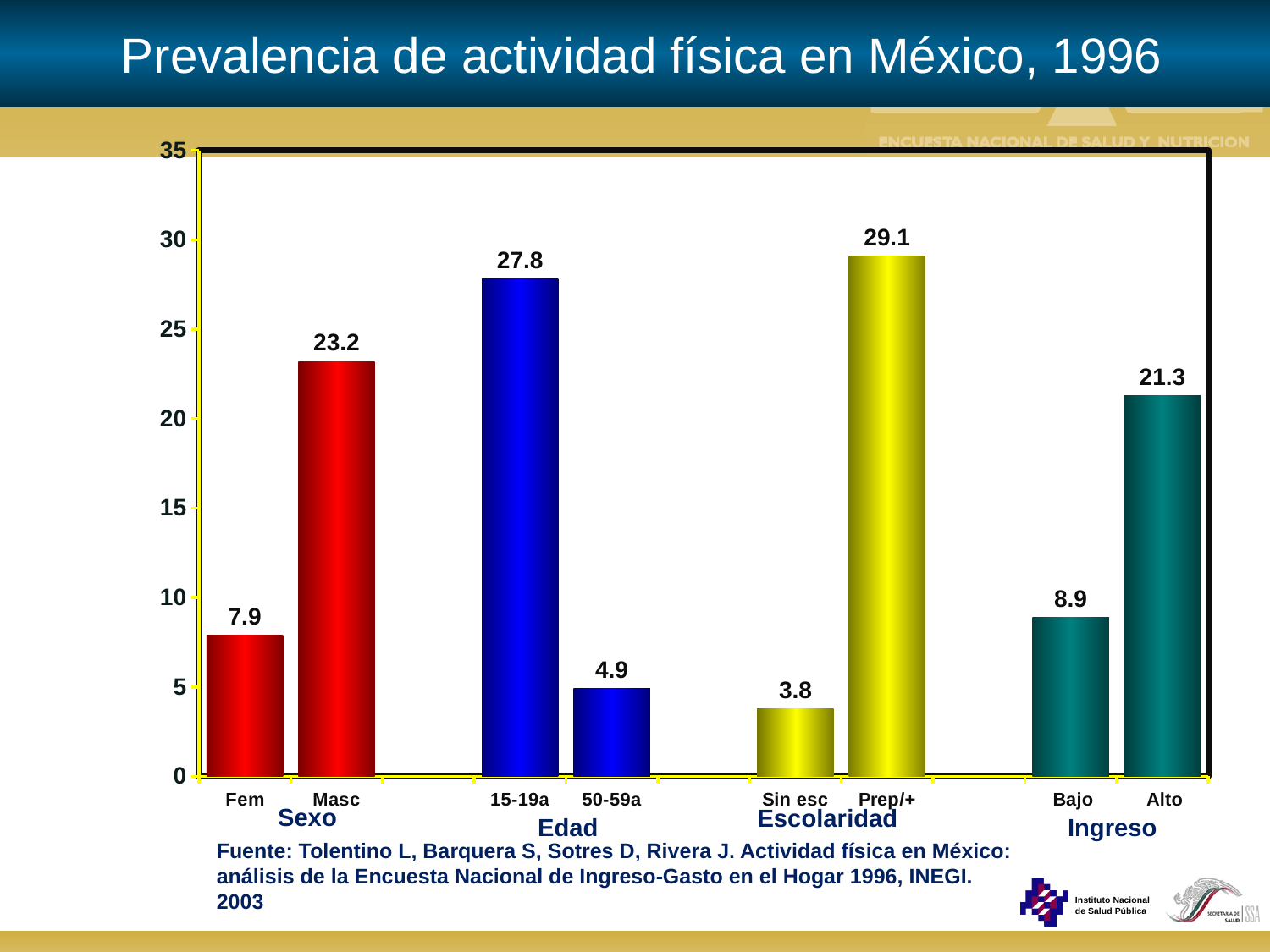
What is the value for 50-59a? 4.9 What is the value for Sin esc? 3.8 What kind of chart is shown on the slide? Bar chart What is the value for Masc? 23.2 How many bars are plotted in the chart? 8 What is the value for Alto? 21.3 What is the difference between the values for Masc and Fem? 15.3 Which is larger, the value for 15-19a or the value for Prep/+? Prep/+ Which category has the lowest value? Sin esc What is the title of the slide? Prevalencia de actividad física en México, 1996 Which category has the highest value? Prep/+ What is the difference between the values for Alto and Bajo? 12.4